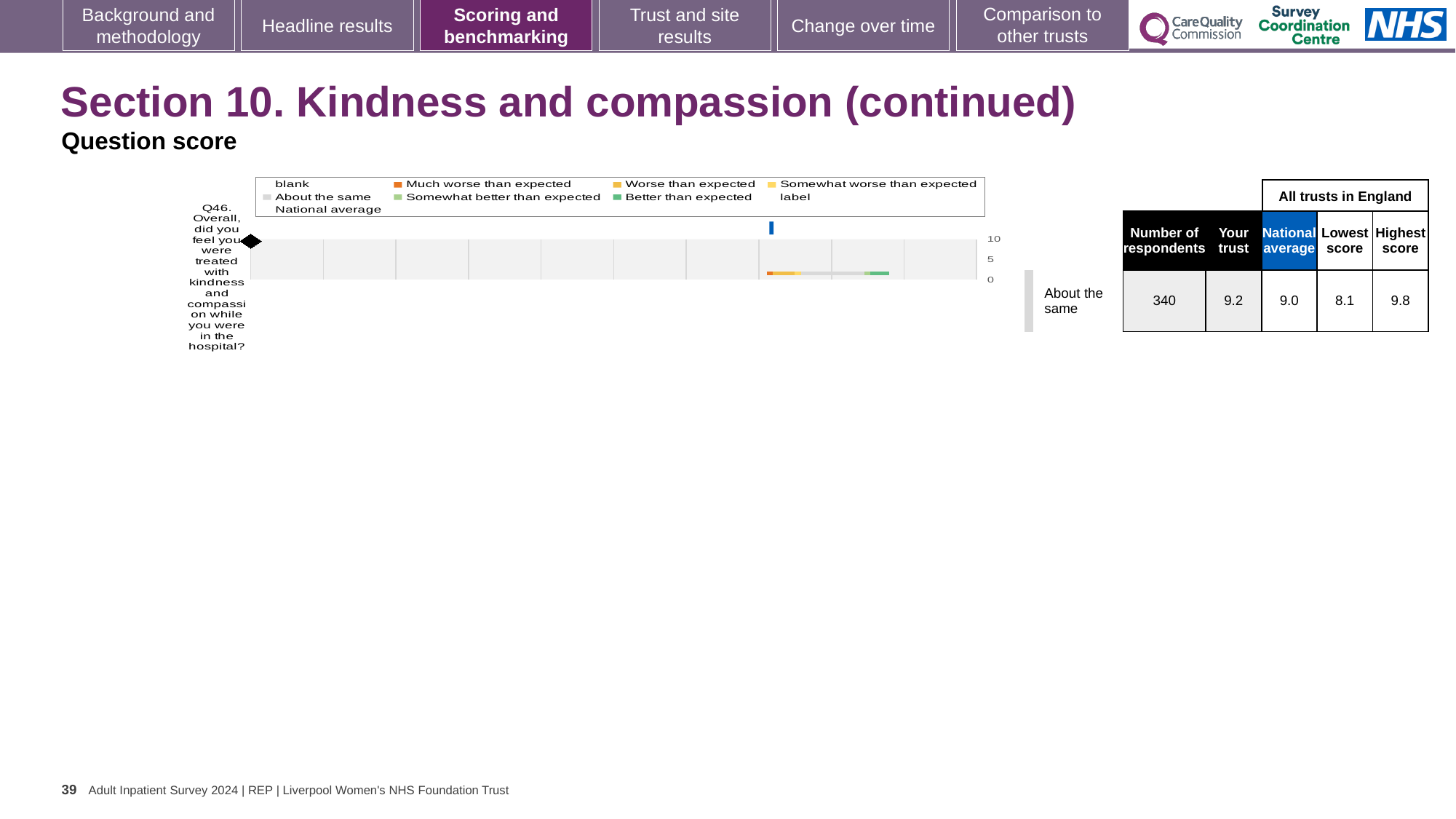
Which is larger for Q46: the Your trust score or the National average? Your trust What is the score for Your trust on Q46 (treated with kindness and compassion)? 9.2 What benchmarking category is the trust's Q46 result placed in? About the same What is the Lowest score among all trusts in England for Q46? 8.1 What is the Highest score among all trusts in England for Q46? 9.8 What kind of chart is used to show the Q46 question score? Bar chart What is the National average score for Q46? 9.0 What is the difference between the Your trust score and the National average for Q46? 0.2 What is the maximum value shown on the chart's score axis? 10 How many respondents answered Q46? 340 What is the difference between the Highest score and the Lowest score for Q46? 1.7 What colour represents 'Better than expected' in the chart legend? Green